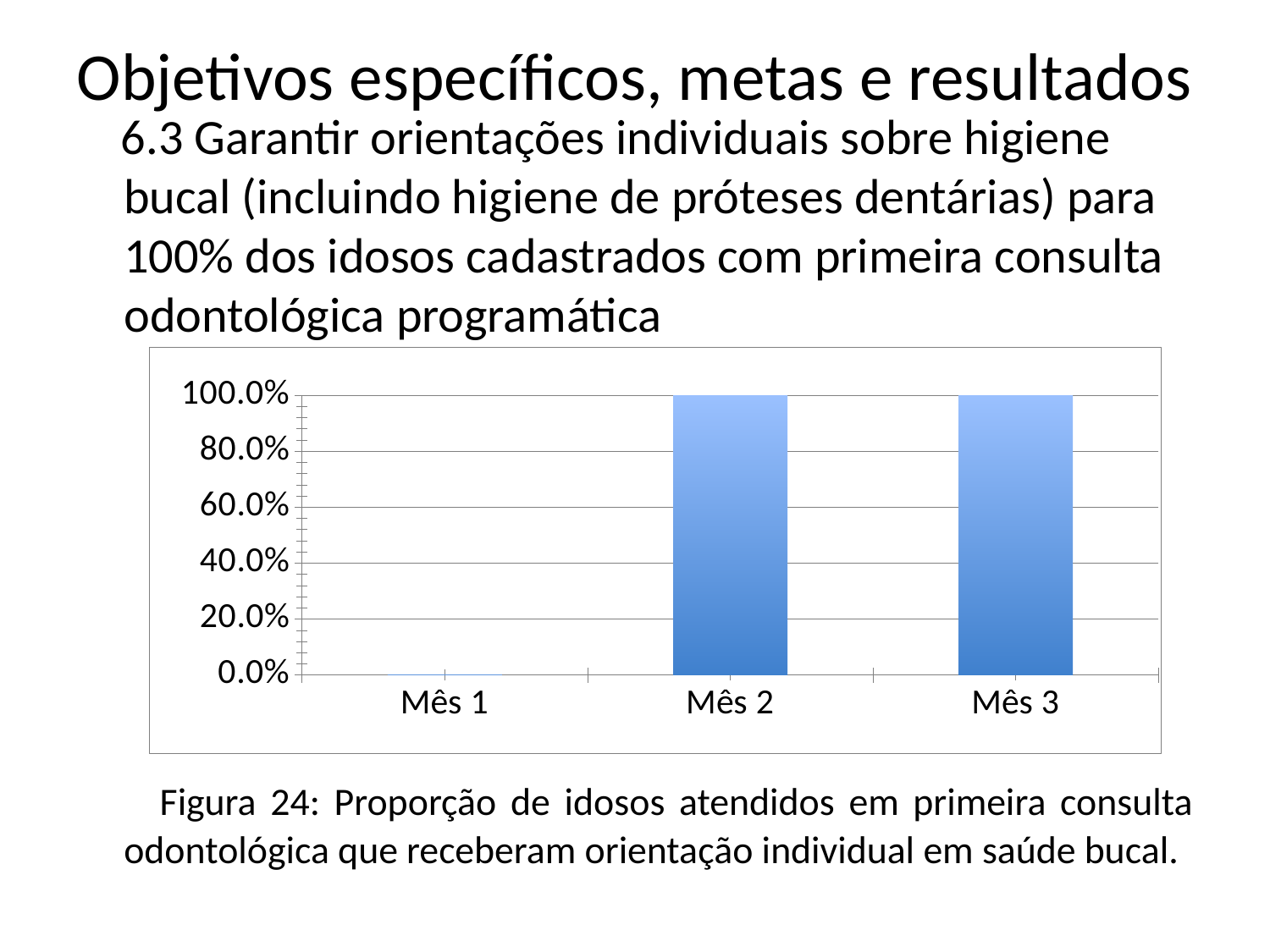
Do the values rise or fall from Mês 1 to Mês 3? rise What is the difference between the values for Mês 2 and Mês 1? 100.0% What is the value for Mês 3? 100.0% Which categories reach 100.0%? Mês 2 and Mês 3 Is the value for Mês 3 greater or less than 80.0%? greater What is the value for Mês 1? 0.0% What figure number is given in the caption below the chart? Figura 24 Which is larger, the value for Mês 1 or the value for Mês 2? Mês 2 What kind of chart is shown on the slide? bar chart How many categories are shown on the x axis of the chart? 3 Which category has the lowest value? Mês 1 What is the value for Mês 2? 100.0%